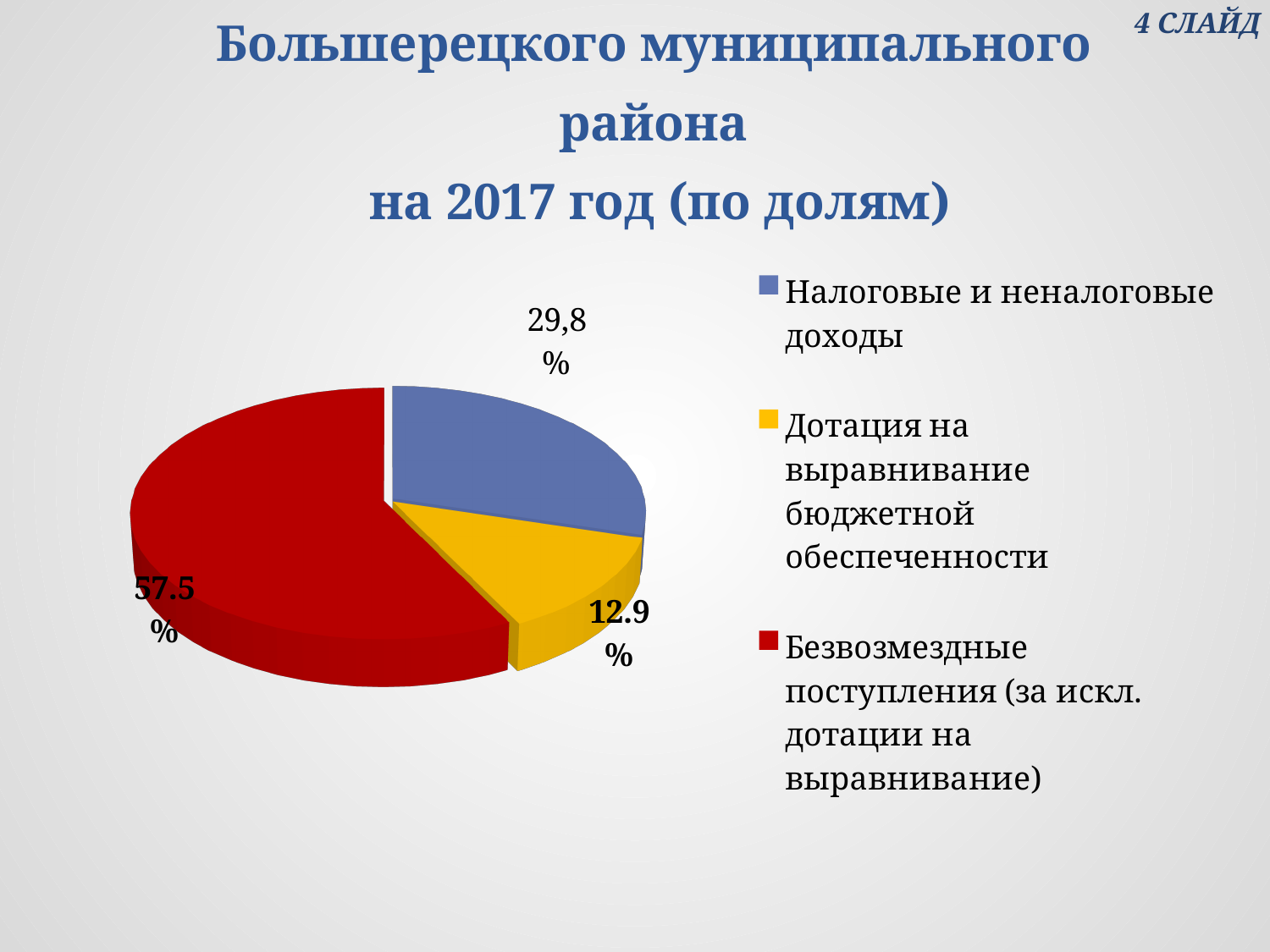
What colour is the slice for Безвозмездные поступления (за искл. дотации на выравнивание)? Red What is the difference in percentage points between Безвозмездные поступления (за искл. дотации на выравнивание) and Налоговые и неналоговые доходы? 27.7 How many entries does the legend list? 3 What share of the pie does Дотация на выравнивание бюджетной обеспеченности have? 12.9% Which category has the smallest slice of the pie? Дотация на выравнивание бюджетной обеспеченности How many slices does the pie chart have? 3 What share of the pie does Налоговые и неналоговые доходы have? 29,8% Which is larger: the share for Налоговые и неналоговые доходы or the share for Дотация на выравнивание бюджетной обеспеченности? Налоговые и неналоговые доходы Which category has the largest slice of the pie? Безвозмездные поступления (за искл. дотации на выравнивание) What kind of chart is shown on the slide? Pie chart What share of the pie does Безвозмездные поступления (за искл. дотации на выравнивание) have? 57.5% What is the difference in percentage points between Налоговые и неналоговые доходы and Дотация на выравнивание бюджетной обеспеченности? 16.9